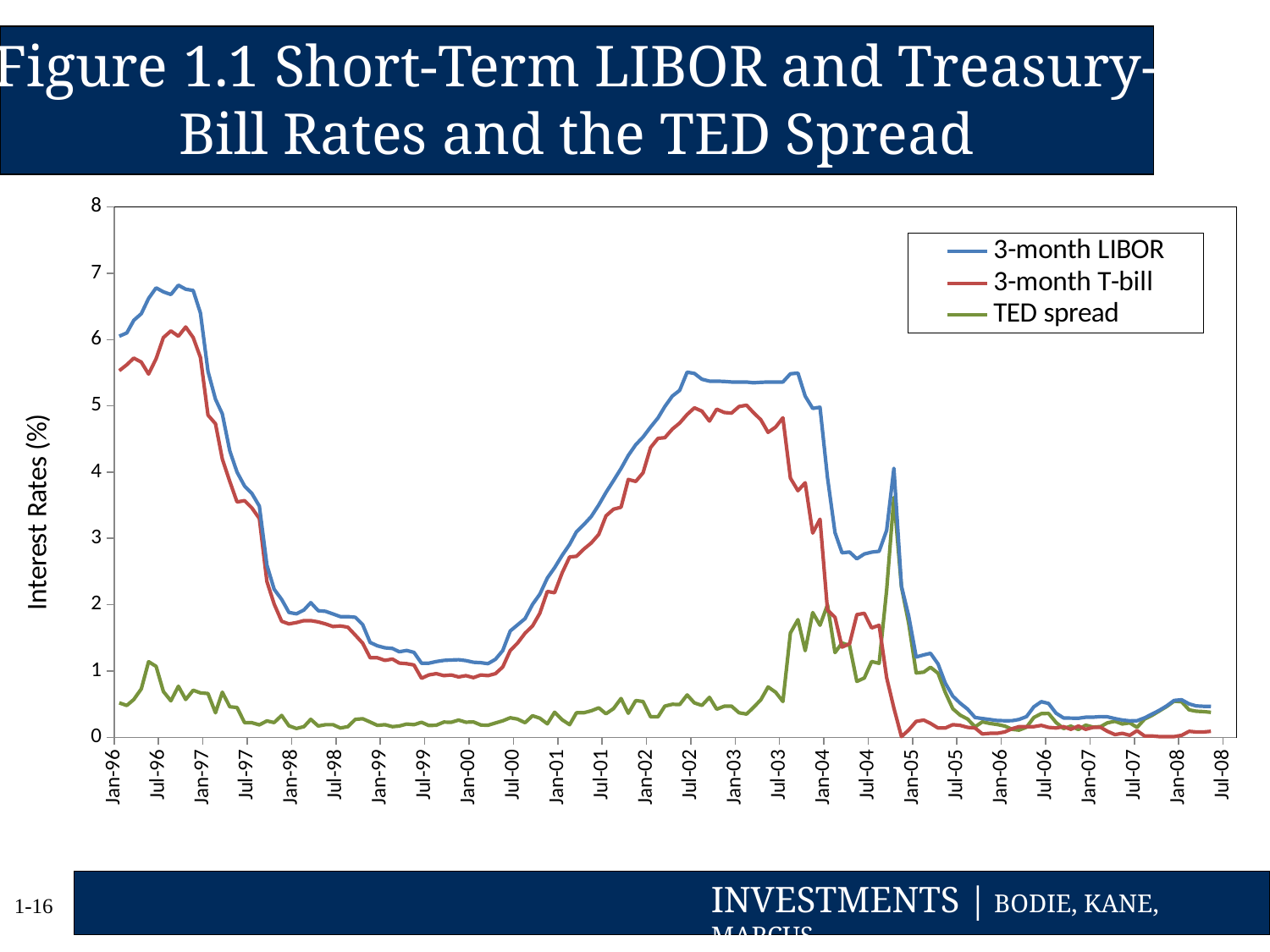
How many series does the legend list? 3 Is the value of 3-month LIBOR at Jul-02 greater or less than 5? greater At Jan-96, which is higher: 3-month LIBOR or 3-month T-bill? 3-month LIBOR What are the three series named in the legend? 3-month LIBOR, 3-month T-bill, TED spread Is the value of the 3-month T-bill at Jan-99 greater or less than 2? less What kind of chart is shown on the slide? Line chart What is the label on the vertical axis? Interest Rates (%) Is the value of the TED spread at Jan-96 greater or less than 1? less Does the 3-month T-bill rate rise or fall between Jan-00 and Jan-02? Rise Does the 3-month LIBOR rate rise or fall between Jan-97 and Jan-99? Fall